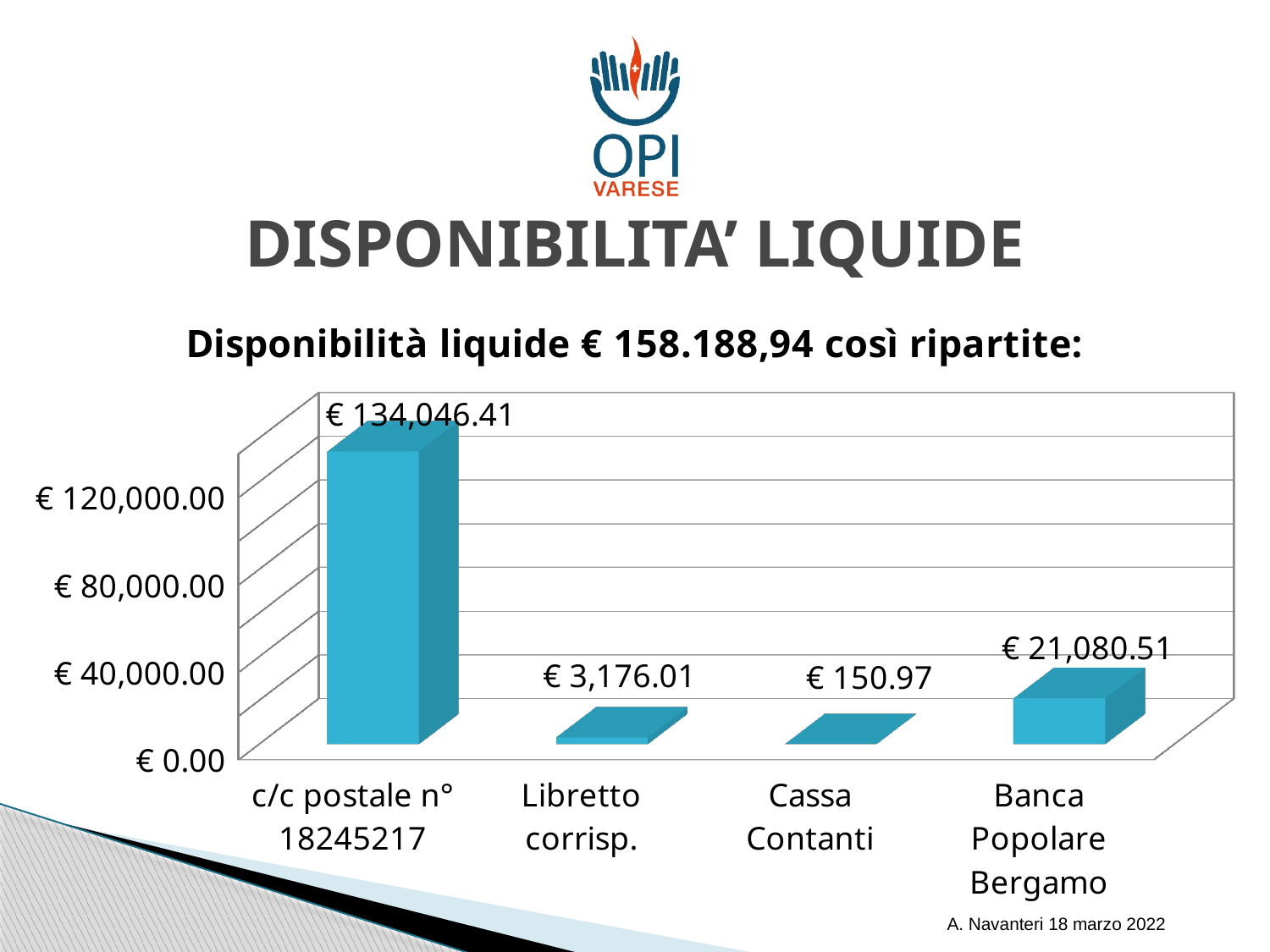
Which category has the highest value? c/c postale n° 18245217 What is the value for c/c postale n° 18245217? € 134,046.41 How many categories are shown in the chart? 4 Is the value for c/c postale n° 18245217 greater or less than € 120,000.00? greater What is the value for Cassa Contanti? € 150.97 What is the value for Libretto corrisp.? € 3,176.01 Which is larger, the value for Libretto corrisp. or the value for Banca Popolare Bergamo? Banca Popolare Bergamo What is the difference between the values for c/c postale n° 18245217 and Banca Popolare Bergamo? € 112,965.90 What kind of chart is shown on the slide? bar chart Which category has the lowest value? Cassa Contanti What is the difference between the values for Banca Popolare Bergamo and Libretto corrisp.? € 17,904.50 What is the value for Banca Popolare Bergamo? € 21,080.51